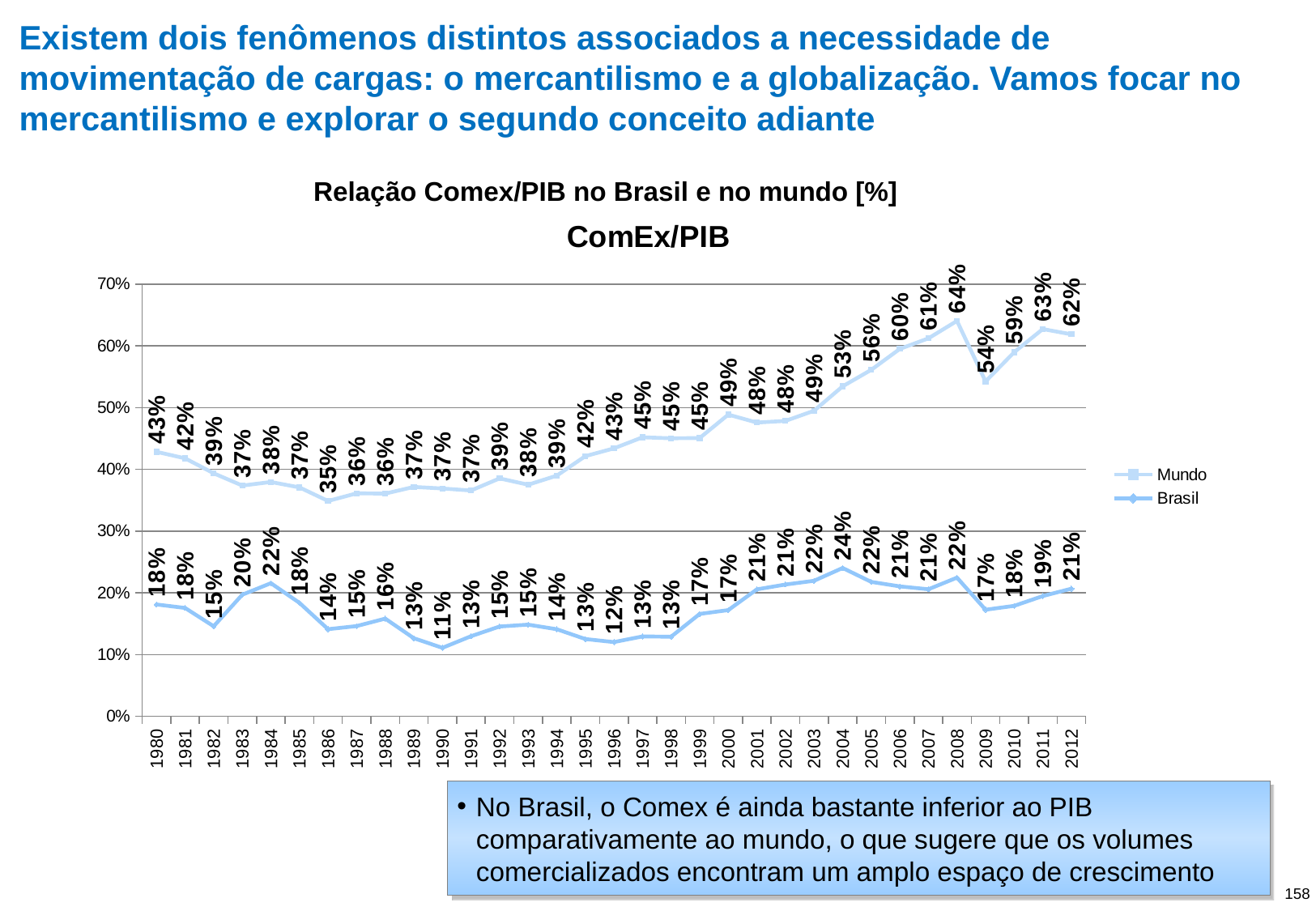
What kind of chart is shown? Line chart Does the Mundo series generally rise or fall from 1986 to 2008? Rise What is the Brasil value for 1990? 11% What is the difference between the Mundo and Brasil values in 2012? 41% In which year does the Brasil series reach its lowest value? 1990 What is the title of the chart? ComEx/PIB What is the Mundo value for 2008? 64% In which year does the Mundo series reach its highest value? 2008 How many series does the legend list? 2 Which series has the higher value in 2004, Mundo or Brasil? Mundo What is the Brasil value for 2012? 21% In which year does the Brasil series reach its highest value? 2004